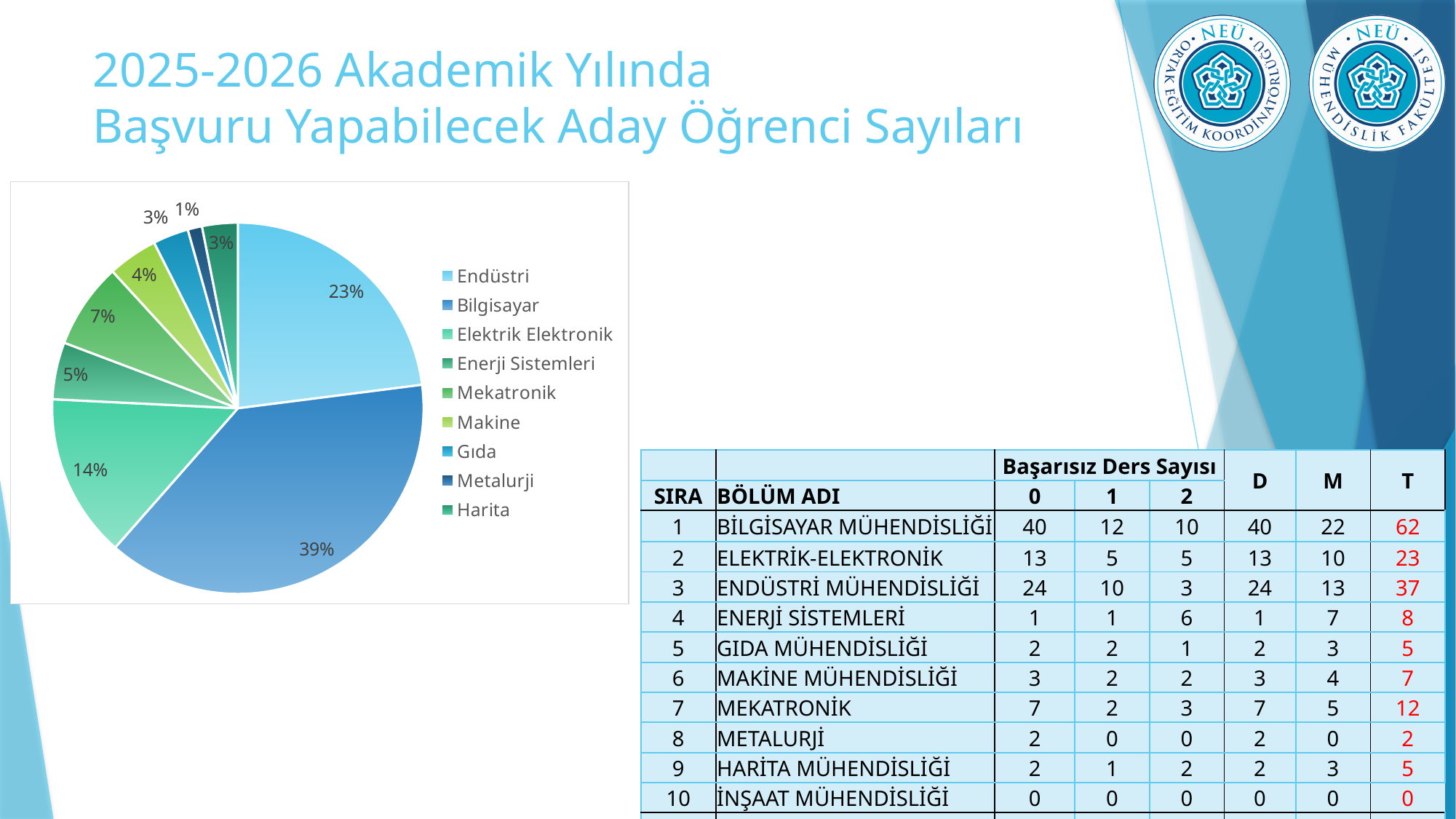
Which slice is larger in the pie chart, Enerji Sistemleri or Mekatronik? Mekatronik Which legend entry is listed first in the pie chart's legend? Endüstri What is the difference in percentage points between the Bilgisayar slice and the Endüstri slice? 16 What percentage of the pie chart does Elektrik Elektronik account for? 14% Which category has the largest slice in the pie chart? Bilgisayar What percentage of the pie chart does Makine account for? 4% What percentage of the pie chart does Endüstri account for? 23% What percentage of the pie chart does Bilgisayar account for? 39% How many categories does the pie chart's legend list? 9 Which category has the smallest slice in the pie chart? Metalurji What percentage of the pie chart does Mekatronik account for? 7% What type of chart is shown on the slide? pie chart